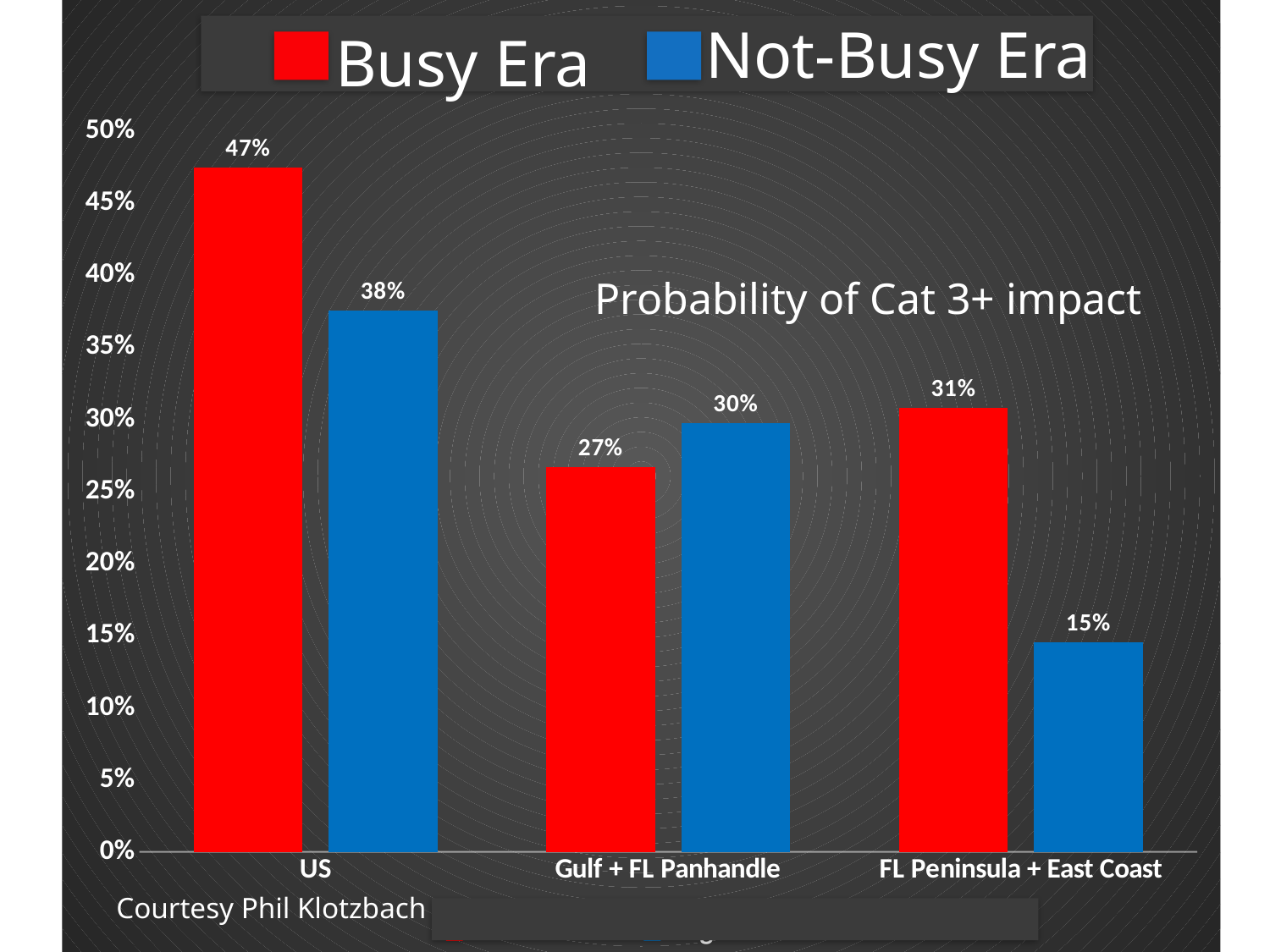
How many series does the legend list? 2 What is the Not-Busy Era value for Gulf + FL Panhandle? 30% Which colour represents the Not-Busy Era series? Blue What kind of chart is shown on the slide? Bar chart How many regions are shown on the x axis? 3 What is the Not-Busy Era probability of Cat 3+ impact for FL Peninsula + East Coast? 15% Which region has the highest Busy Era probability? US Which region has the lowest Not-Busy Era probability? FL Peninsula + East Coast What is the Busy Era probability of Cat 3+ impact for the US? 47% What is the difference between the Busy Era and Not-Busy Era values for the US? 9% What is the difference between the Busy Era and Not-Busy Era values for FL Peninsula + East Coast? 16% For Gulf + FL Panhandle, which is larger: the Busy Era value or the Not-Busy Era value? Not-Busy Era